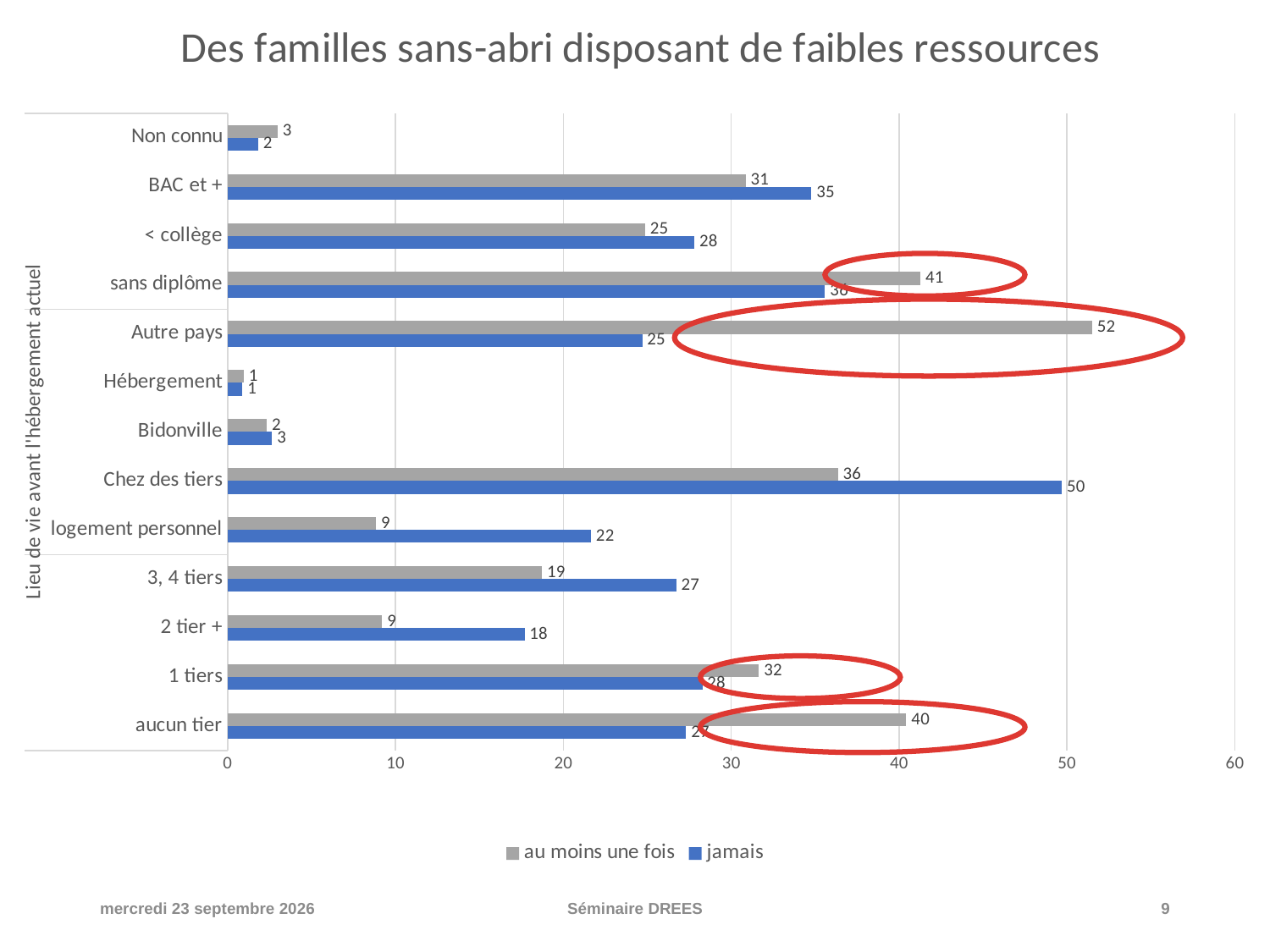
For 'BAC et +', which series has the larger value, 'au moins une fois' or 'jamais'? jamais What is the value of 'jamais' for 'Chez des tiers'? 50 What kind of chart is shown on the slide? bar chart What is the value of 'au moins une fois' for 'Autre pays'? 52 How many categories are shown on the vertical axis of the chart? 13 Which category has the highest value for the 'jamais' series? Chez des tiers What is the value of 'au moins une fois' for 'logement personnel'? 9 What is the value of 'jamais' for '2 tier +'? 18 For 'Chez des tiers', what is the difference between the 'jamais' value and the 'au moins une fois' value? 14 Which category has the highest value for the 'au moins une fois' series? Autre pays For 'Autre pays', what is the difference between the 'au moins une fois' value and the 'jamais' value? 27 How many series does the legend list? 2